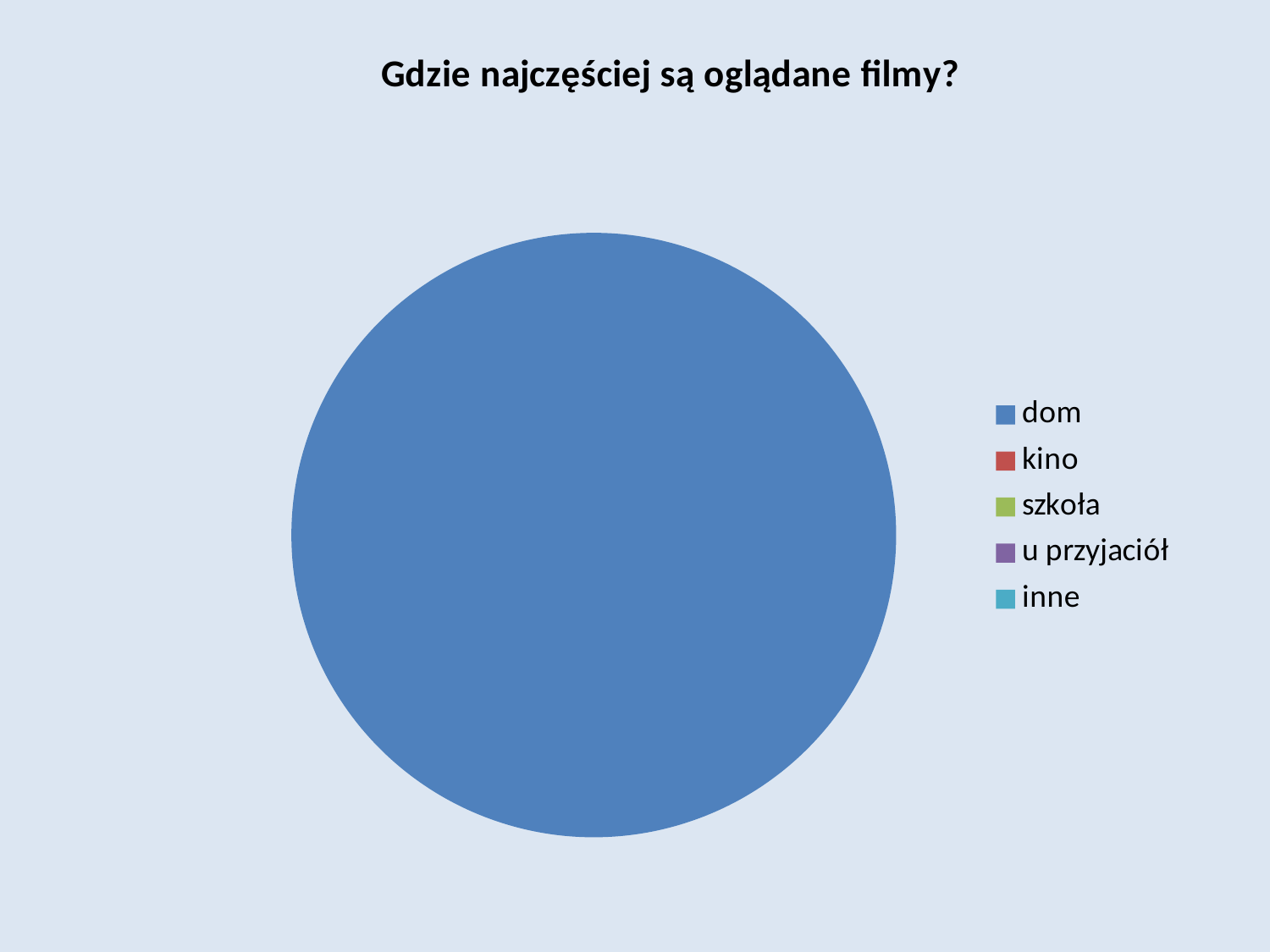
What is the title of the chart? Gdzie najczęściej są oglądane filmy? What kind of chart is shown on the slide? pie chart Which is larger, the share for dom or the share for u przyjaciół? dom Which category is represented by the blue colour in the legend? dom Which is larger, the share for dom or the share for szkoła? dom Which is larger, the share for dom or the share for kino? dom How many categories does the legend list? 5 Which category has the largest share of the pie? dom